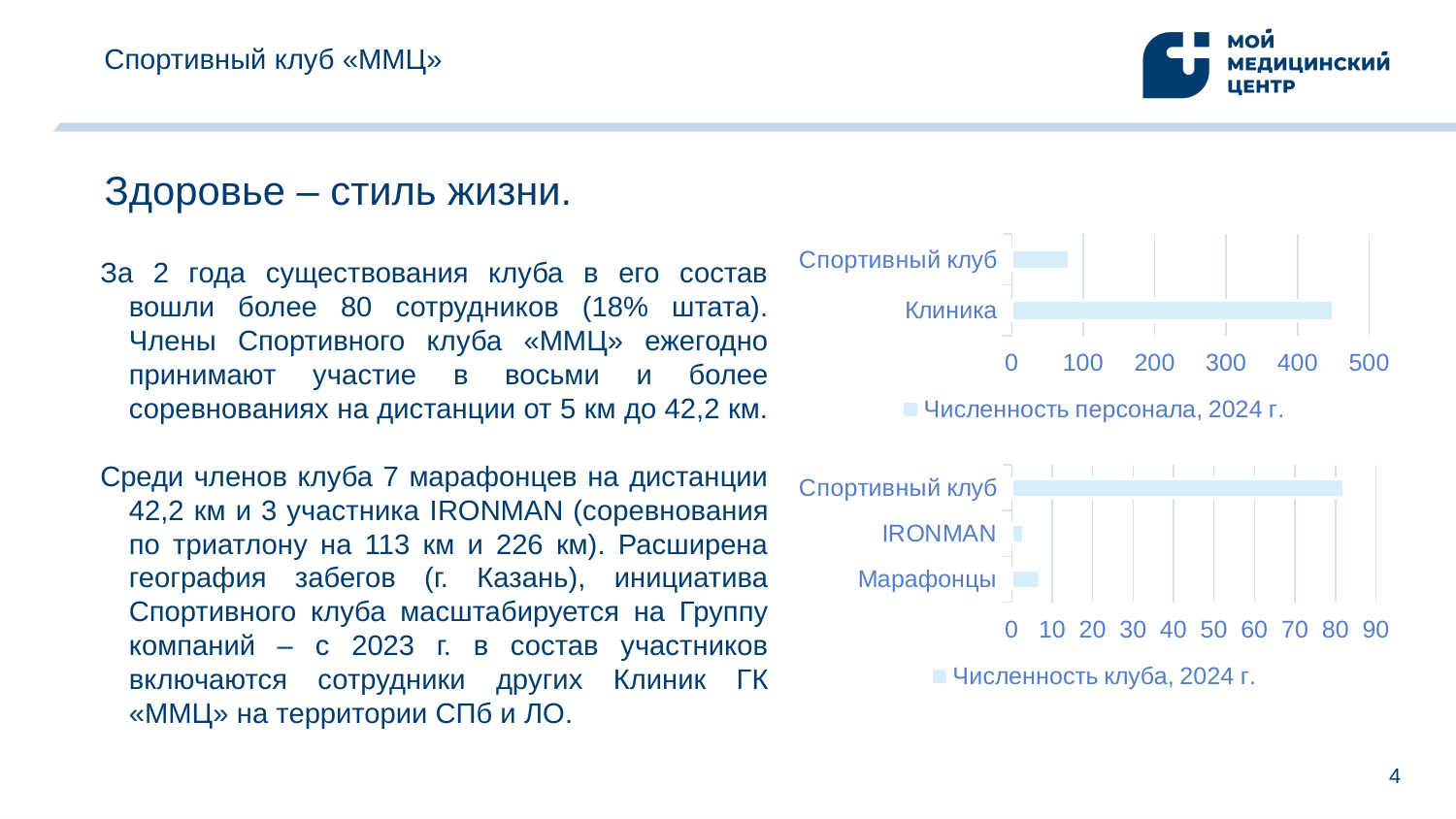
In the bottom chart ("Численность клуба, 2024 г."), which is larger: Марафонцы or IRONMAN? Марафонцы How many categories does the top chart ("Численность персонала, 2024 г.") show? 2 In the bottom chart ("Численность клуба, 2024 г."), is the value for Спортивный клуб greater or less than 70? greater In the top chart ("Численность персонала, 2024 г."), which category has the highest value? Клиника How many categories does the bottom chart ("Численность клуба, 2024 г.") show? 3 What type of chart is the top chart with legend "Численность персонала, 2024 г."? bar chart In the bottom chart ("Численность клуба, 2024 г."), which category has the lowest value? IRONMAN How many series does the legend of the top chart list? 1 In the top chart ("Численность персонала, 2024 г."), is the value for Клиника greater or less than 400? greater In the bottom chart ("Численность клуба, 2024 г."), which category has the highest value? Спортивный клуб What is the legend entry of the bottom chart? Численность клуба, 2024 г. In the top chart ("Численность персонала, 2024 г."), is the value for Спортивный клуб greater or less than 100? less